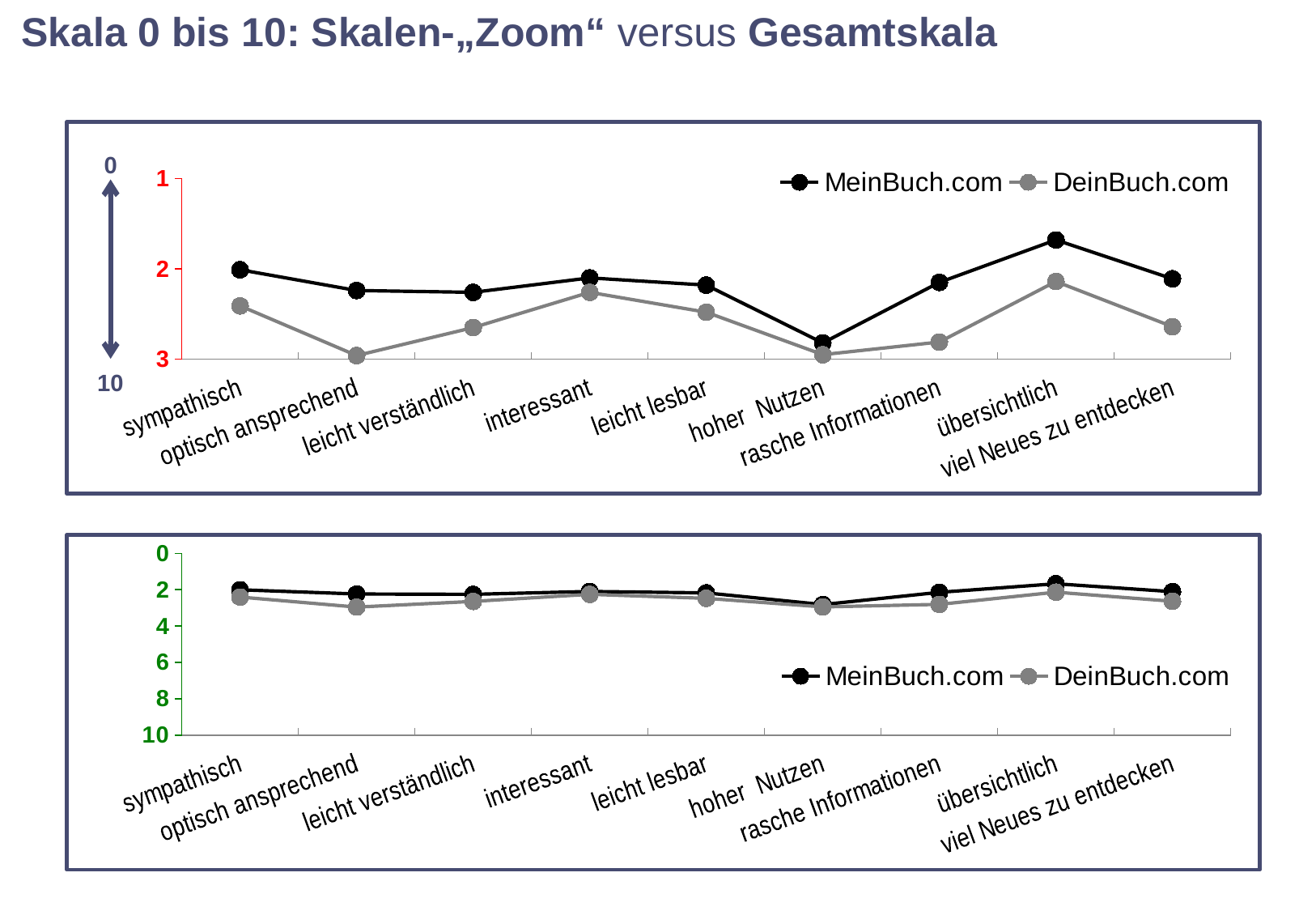
In the top chart, which category has the lowest value for MeinBuch.com? übersichtlich In the top chart, is the value for MeinBuch.com at "hoher Nutzen" greater or less than 2? greater In the top chart, is the value for DeinBuch.com at "sympathisch" greater or less than 2? greater What type of chart is the top chart on the slide? line chart How many series does the legend of the top chart list? 2 In the top chart, which category has the highest value for MeinBuch.com? hoher Nutzen What are the two series named in the legend of the bottom chart? MeinBuch.com and DeinBuch.com In the top chart, which category has the lowest value for DeinBuch.com? übersichtlich In the top chart, is the value for MeinBuch.com at "übersichtlich" greater or less than 2? less How many categories are shown on the x axis of the bottom chart? 9 What range does the y axis of the bottom chart cover? 0 to 10 In the top chart, for the category "sympathisch", which series has the larger value, MeinBuch.com or DeinBuch.com? DeinBuch.com